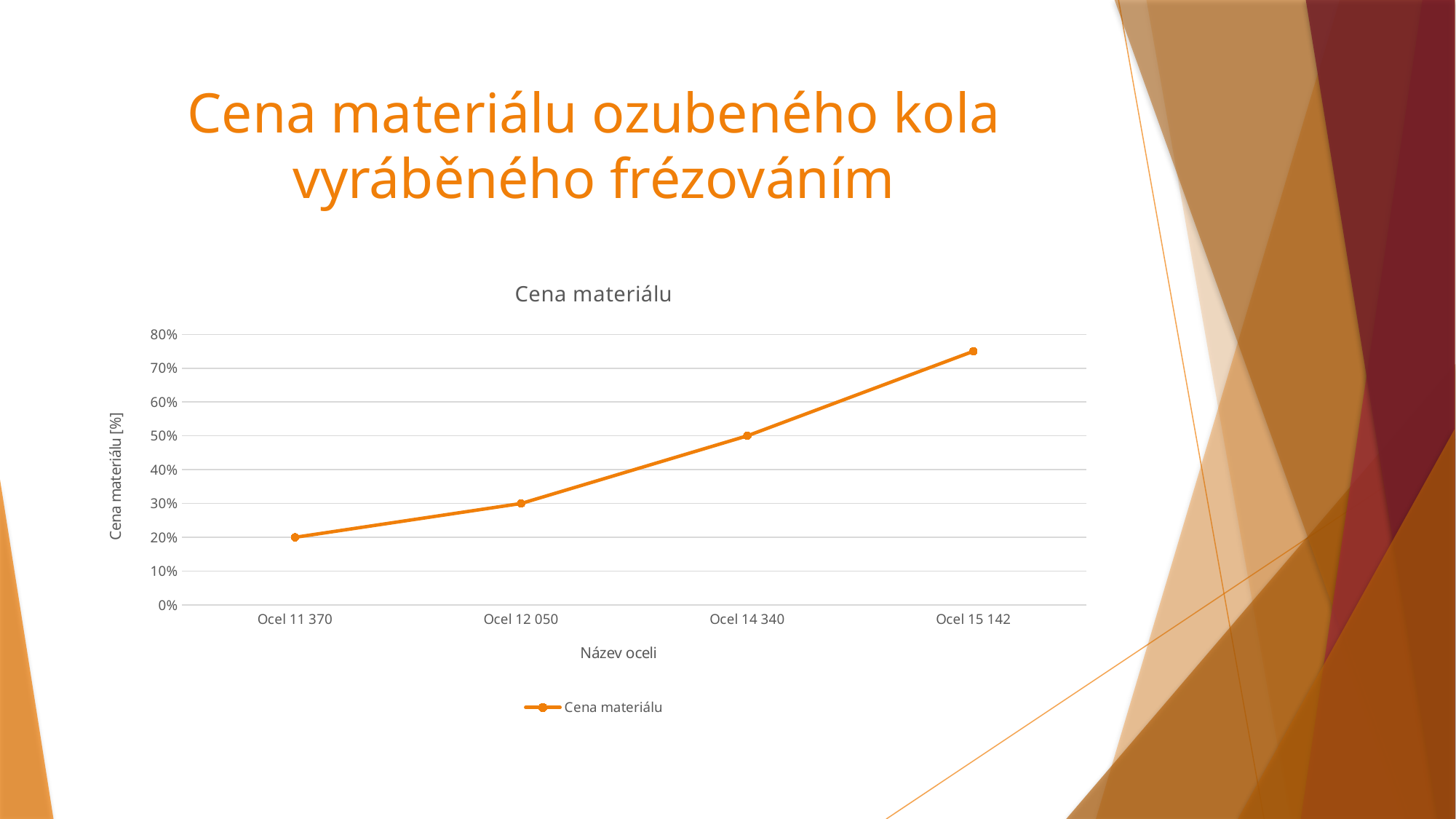
How many steel types are plotted on the x axis? 4 What is the value for Ocel 14 340? 50% Which steel type has the lowest value? Ocel 11 370 Do the values rise or fall from left to right along the x axis? rise What is the value for Ocel 12 050? 30% What is the title of the chart? Cena materiálu Is the value for Ocel 15 142 greater or less than 70%? greater What is the value for Ocel 11 370? 20% What kind of chart is shown on the slide? line chart Which steel type has the highest value? Ocel 15 142 How many series does the legend list? 1 What is the difference between the values for Ocel 14 340 and Ocel 11 370? 30%